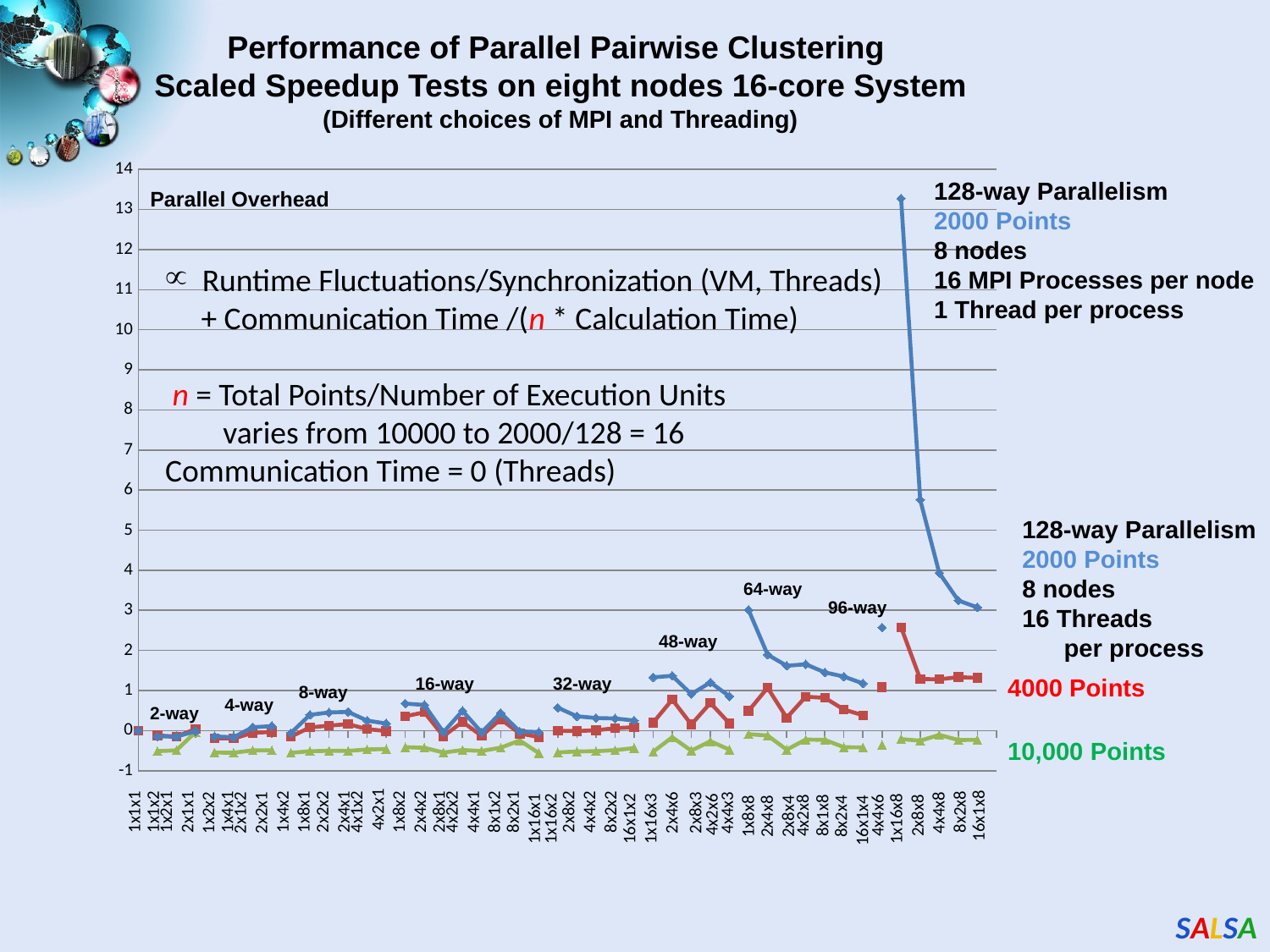
At 1x16x8, which series has the larger parallel overhead, 2000 Points or 4000 Points? 2000 Points Is the parallel overhead for 4000 Points at 1x16x8 greater or less than 2? greater What quantity does the chart plot, according to the label at the top left of the plot area? Parallel Overhead What is the highest value shown on the vertical axis of the chart? 14 Is the parallel overhead for 2000 Points at 2x8x8 greater or less than 3? greater For the 2000 Points series, does the parallel overhead rise or fall from 1x16x8 to 16x1x8? fall How many data series (point counts) are plotted on the chart? 3 Which series reaches the highest parallel overhead on the chart? 2000 Points Is the parallel overhead for 2000 Points at 1x16x8 (128-way, 1 thread per process) greater or less than 10? greater What kind of chart is shown on the slide? line chart Which series has the lowest parallel overhead values across the chart? 10,000 Points